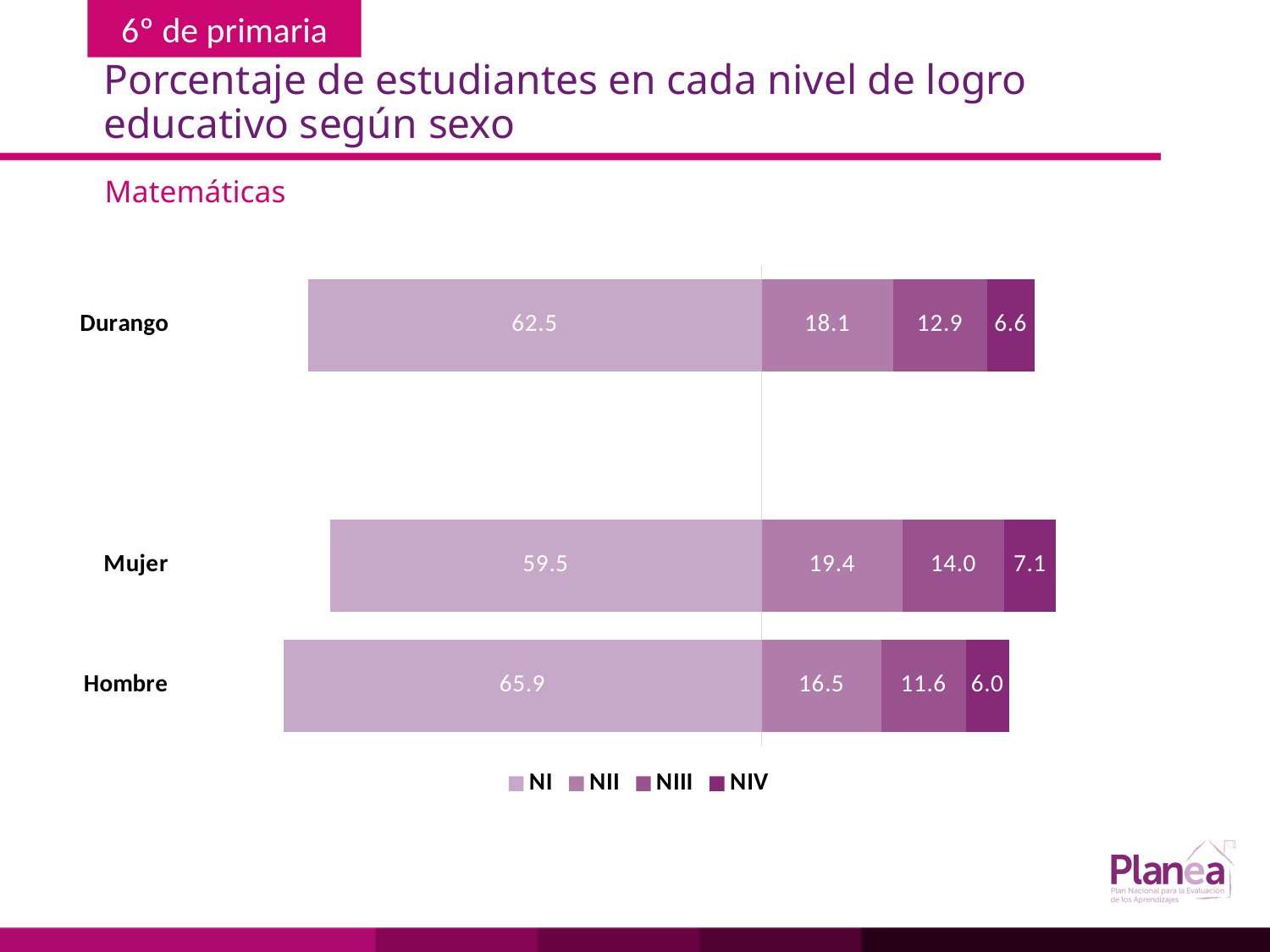
What is the difference between the NI values for Hombre and Mujer? 6.4 How many categories are shown on the chart? 3 What is the NIII value for Durango? 12.9 What is the NI value for Durango? 62.5 Which category has the lowest NIV value? Hombre Which is larger, the NII value for Mujer or the NII value for Durango? Mujer How many series does the legend list? 4 Which category has the highest NI value? Hombre What is the NIV value for Mujer? 7.1 What is the NII value for Hombre? 16.5 What is the total of the stacked bar for Hombre? 100.0 What kind of chart is shown on the slide? Stacked bar chart